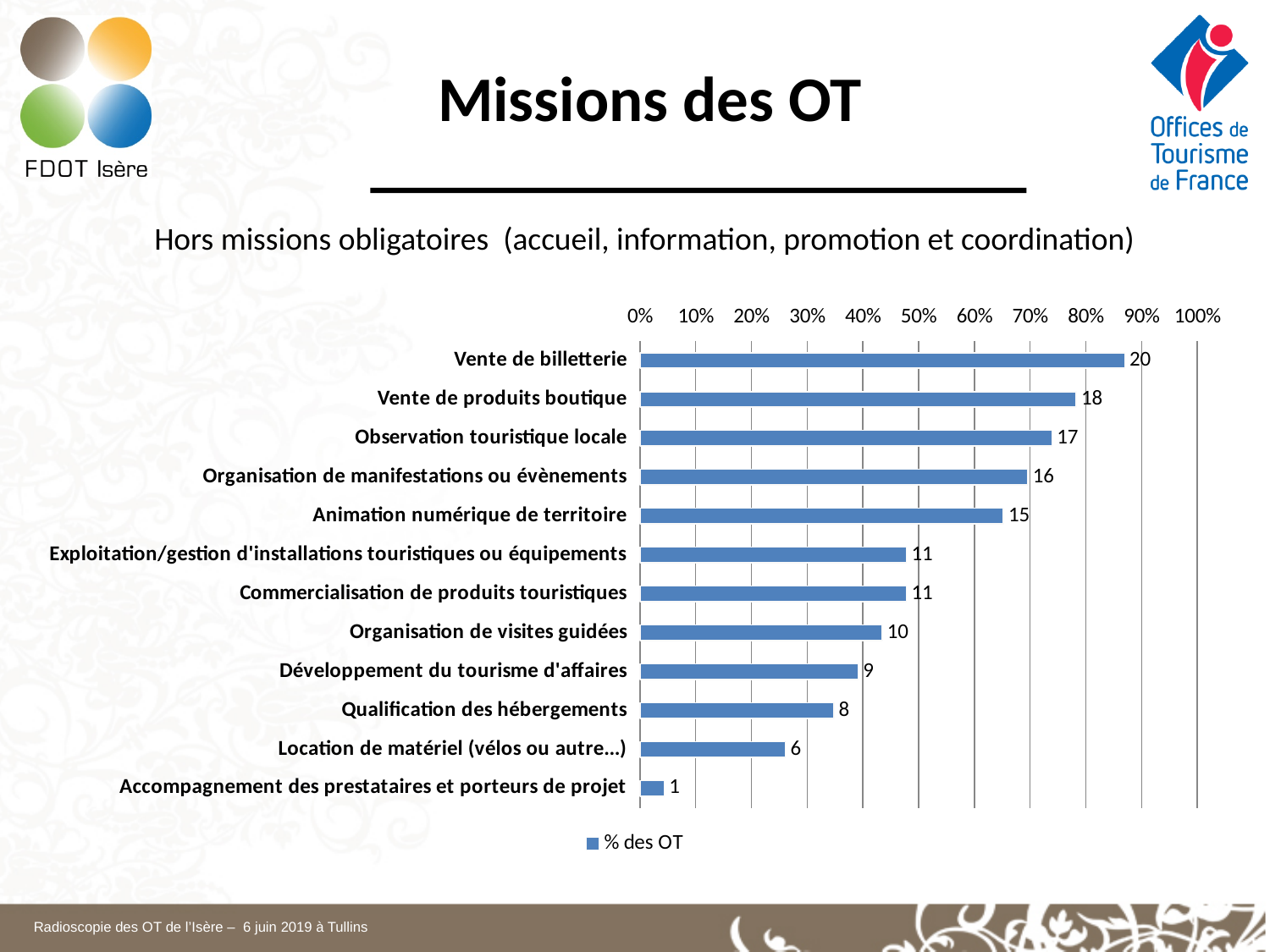
Which category has the highest value? Vente de billetterie What is the legend entry of the chart? % des OT What is the data label for "Location de matériel (vélos ou autre...)"? 6 What is the data label for "Animation numérique de territoire"? 15 Which is larger: the value for "Organisation de visites guidées" or the value for "Qualification des hébergements"? Organisation de visites guidées What is the data label for "Vente de billetterie"? 20 Which category has the lowest value? Accompagnement des prestataires et porteurs de projet Is the bar for "Observation touristique locale" greater or less than 50% on the axis? greater What kind of chart is shown on the slide? bar chart How many series does the legend list? 1 What is the difference between the data labels for "Vente de billetterie" and "Vente de produits boutique"? 2 How many categories are shown in the chart? 12